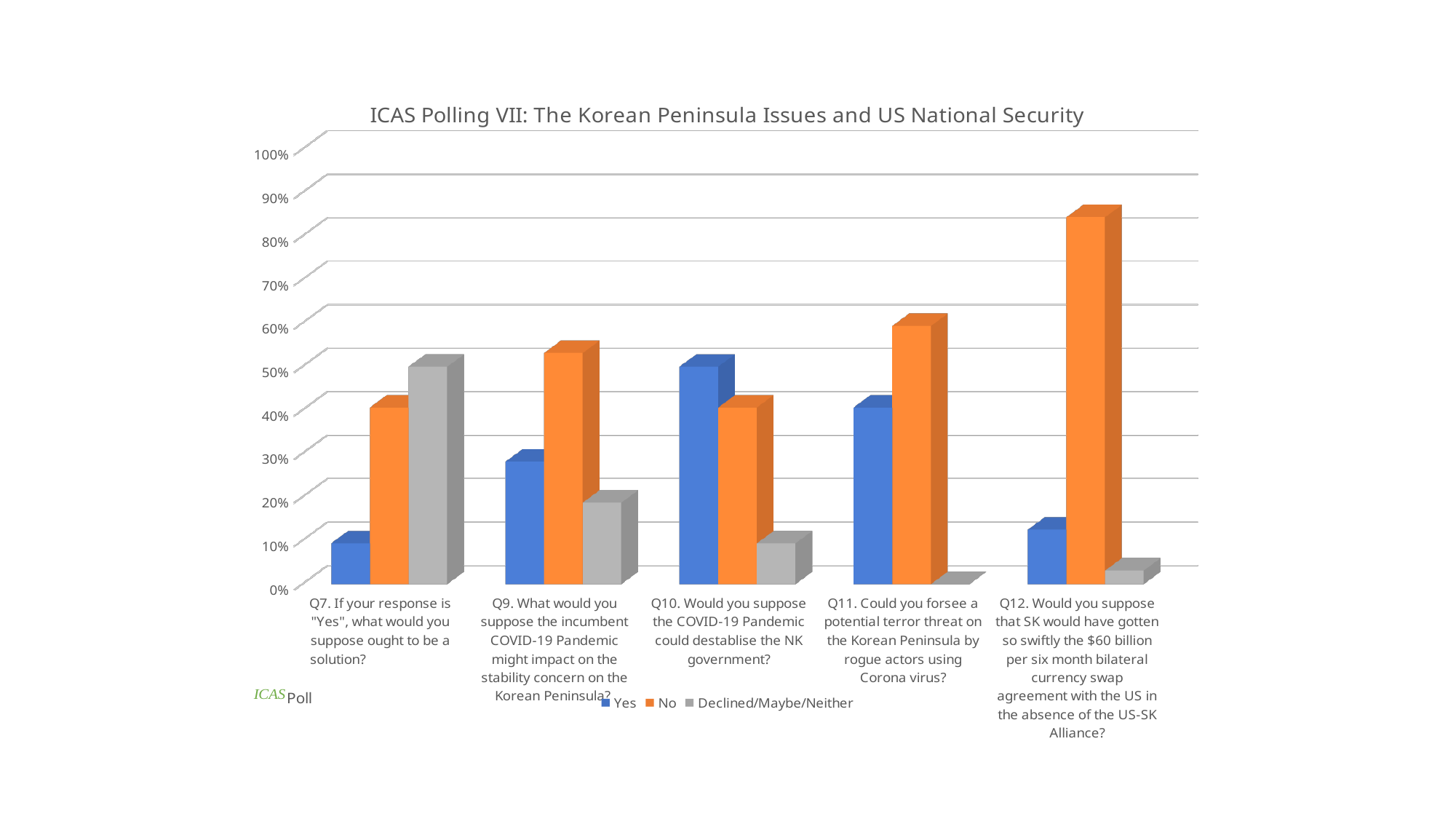
For which poll question is the "No" bar the highest? Q12 Is the "Yes" value for Q7 greater or less than 20%? less Which series is shown in orange in the legend? No What is the title of the chart? ICAS Polling VII: The Korean Peninsula Issues and US National Security How many poll questions (categories) are shown on the x axis? 5 For which poll question is the "Yes" bar the highest? Q10 For Q10, which is larger, the "Yes" bar or the "No" bar? Yes What kind of chart is shown on the slide? bar chart Is the "No" value for Q12 greater or less than 70%? greater How many series does the legend list? 3 Is the "No" value for Q11 greater or less than 50%? greater For Q7, which is larger, the "No" bar or the "Declined/Maybe/Neither" bar? Declined/Maybe/Neither